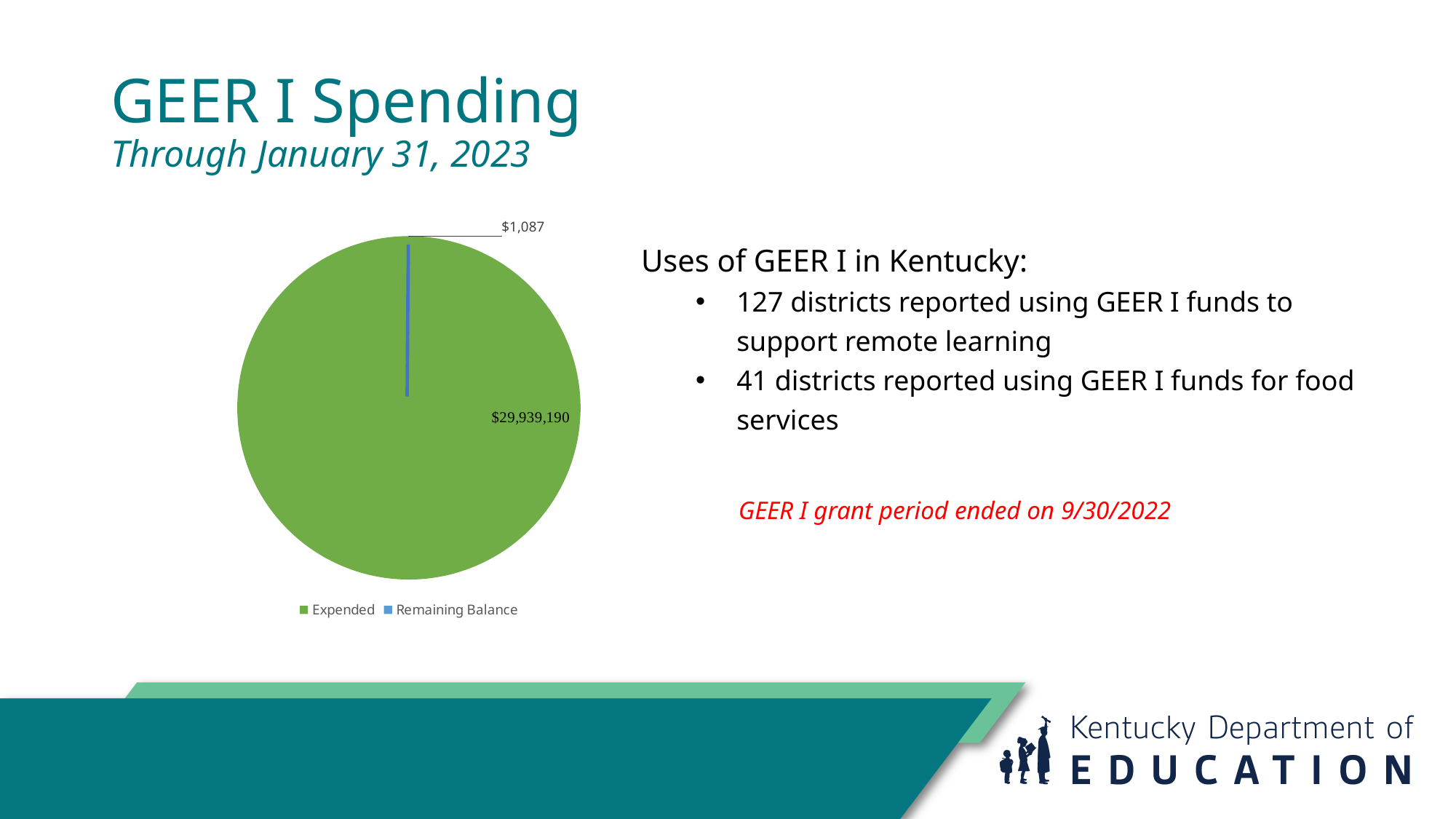
What is the difference between the Expended value and the Remaining Balance value? $29,938,103 Which slice of the pie chart is the smallest? Remaining Balance How many entries does the chart legend list? 2 What kind of chart is shown on the slide? Pie chart What is the value of the Remaining Balance slice in the pie chart? $1,087 What are the two legend entries of the pie chart? Expended and Remaining Balance How many slices does the pie chart have? 2 What colour is the Expended slice in the pie chart? Green Which slice of the pie chart is the largest? Expended What is the total of the two slices in the pie chart? $29,940,277 What is the value of the Expended slice in the pie chart? $29,939,190 Which is larger, the Expended value or the Remaining Balance value? Expended